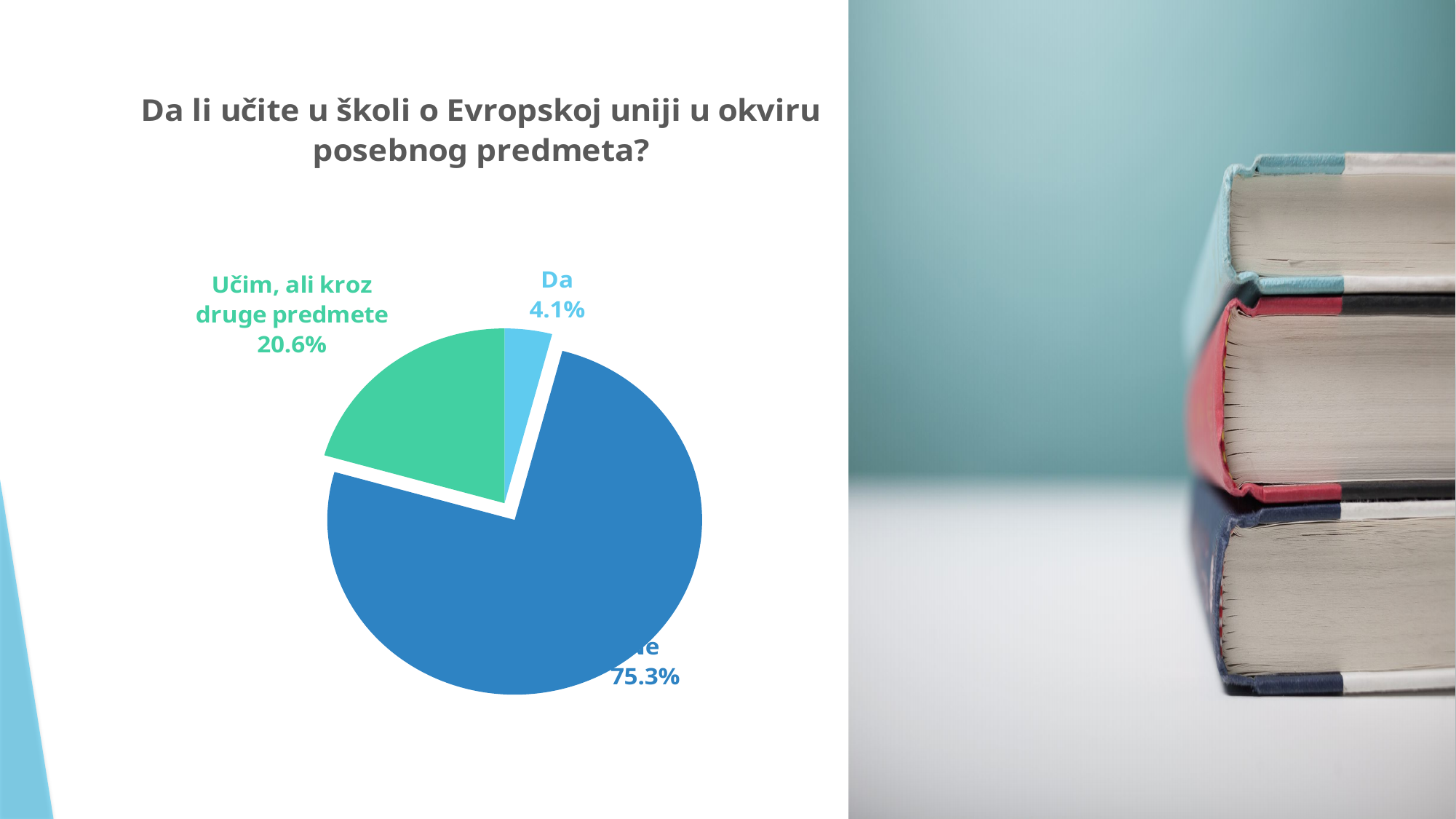
Is the value for "Učim, ali kroz druge predmete" greater or less than 25%? less Which slice of the pie chart is the smallest? Da What is the percentage of the largest slice in the pie chart? 75.3% What is the combined percentage of the "Da" and "Učim, ali kroz druge predmete" slices? 24.7% What kind of chart is shown on the slide? pie chart What percentage is shown for the slice labelled "Da"? 4.1% What is the title of the chart? Da li učite u školi o Evropskoj uniji u okviru posebnog predmeta? Which is larger: the slice for "Da" or the slice for "Učim, ali kroz druge predmete"? Učim, ali kroz druge predmete How many slices does the pie chart have? 3 What percentage is shown for the slice labelled "Učim, ali kroz druge predmete"? 20.6% What is the difference in percentage points between "Učim, ali kroz druge predmete" and "Da"? 16.5% What colour is the slice labelled "Da"? light blue